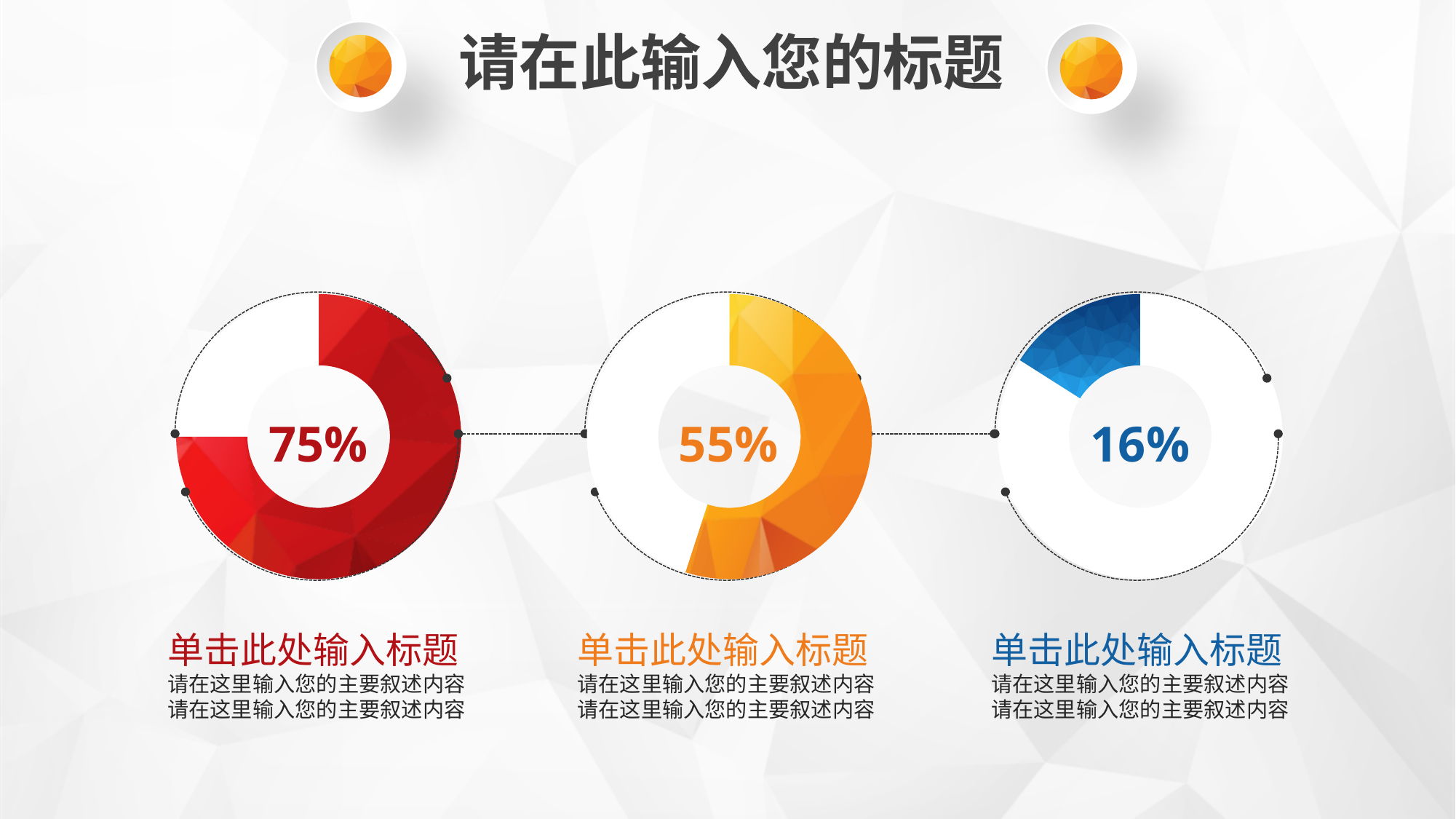
What is the difference between the percentage in the middle donut chart and the percentage in the right donut chart? 39% Which of the three donut charts shows the highest percentage? The left (red) chart, 75% What kind of chart is used to display the percentages on this slide? Donut chart Which of the three donut charts shows the lowest percentage? The right (blue) chart, 16% What is the difference between the percentage in the left donut chart and the percentage in the middle donut chart? 20% Which is larger: the value in the middle donut chart or the value in the right donut chart? The middle donut chart (55%) What value is shown in the centre of the left (red) donut chart? 75% What is the difference between the percentage in the left donut chart and the percentage in the right donut chart? 59% What colour is the filled ring of the donut chart showing 16%? Blue What value is shown in the centre of the right (blue) donut chart? 16% How many donut charts are shown on the slide? 3 What value is shown in the centre of the middle (orange) donut chart? 55%